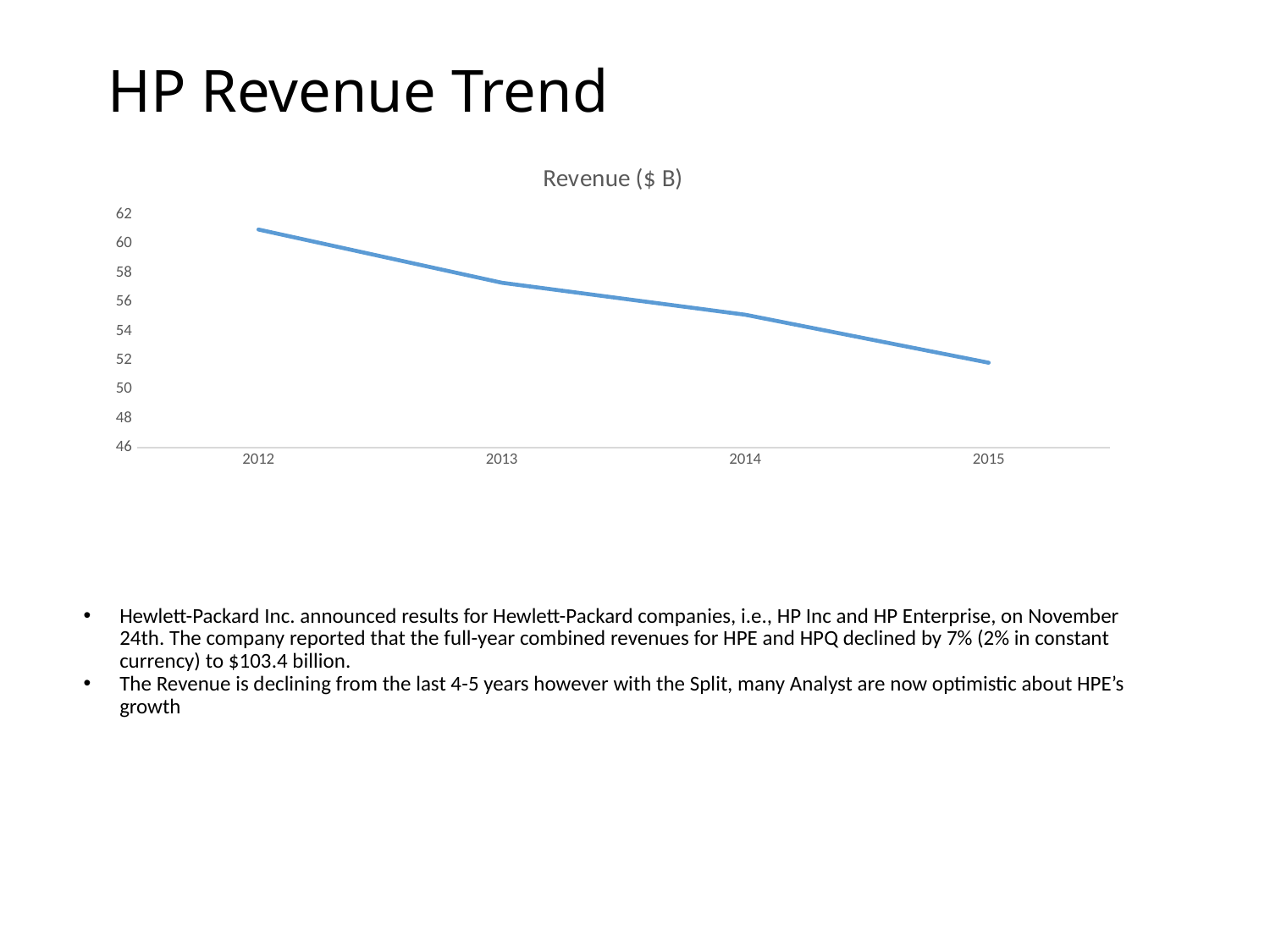
What is the lowest value shown on the y axis of the chart? 46 Do the revenue values rise or fall from 2012 to 2015? fall Is the value for 2014 greater or less than 56? less Which year has the larger revenue, 2013 or 2015? 2013 Is the value for 2013 greater or less than 58? less What kind of chart is shown on the slide? line chart Which year has the highest revenue in the chart? 2012 What is the title of the chart? Revenue ($ B) How many years are plotted on the x axis of the chart? 4 Is the value for 2015 greater or less than 54? less Which year has the lowest revenue in the chart? 2015